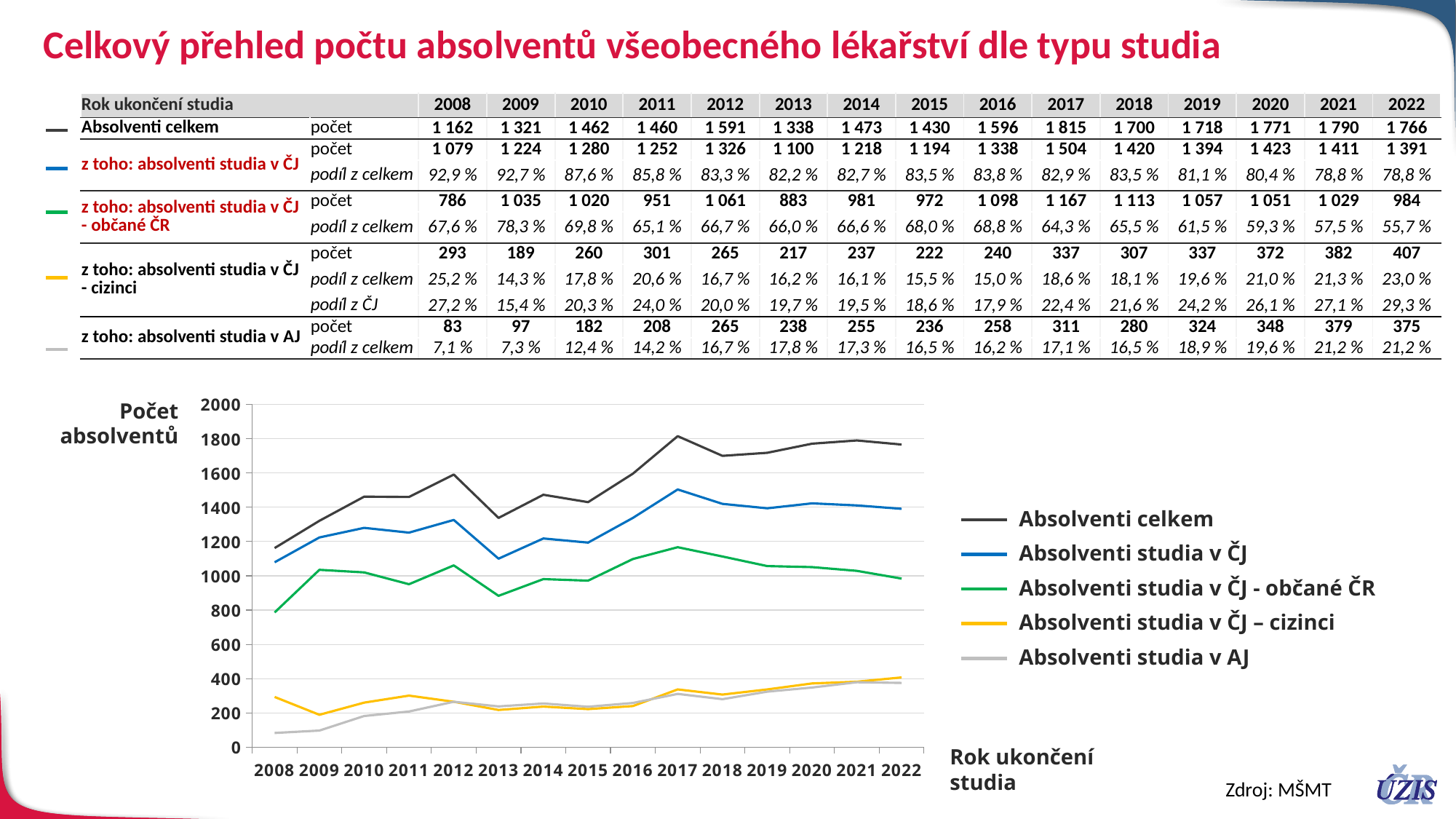
What kind of chart is shown on the slide? line chart In 2022, which is larger: Absolventi studia v ČJ – cizinci or Absolventi studia v AJ? Absolventi studia v ČJ – cizinci What is the label on the vertical axis of the chart? Počet absolventů What is the value of Absolventi studia v AJ in 2022? 375 What is the value of Absolventi studia v ČJ - občané ČR in 2017? 1 167 Does the Absolventi studia v AJ series generally rise or fall from 2008 to 2022? rise By how much did Absolventi celkem increase from 2008 to 2022? 604 How many years are plotted along the x axis of the chart? 15 How many series does the chart legend list? 5 In which year is the Absolventi celkem series at its lowest? 2008 In which year does the Absolventi celkem series reach its highest value? 2017 Is the value for Absolventi studia v AJ in 2008 greater or less than 200? less